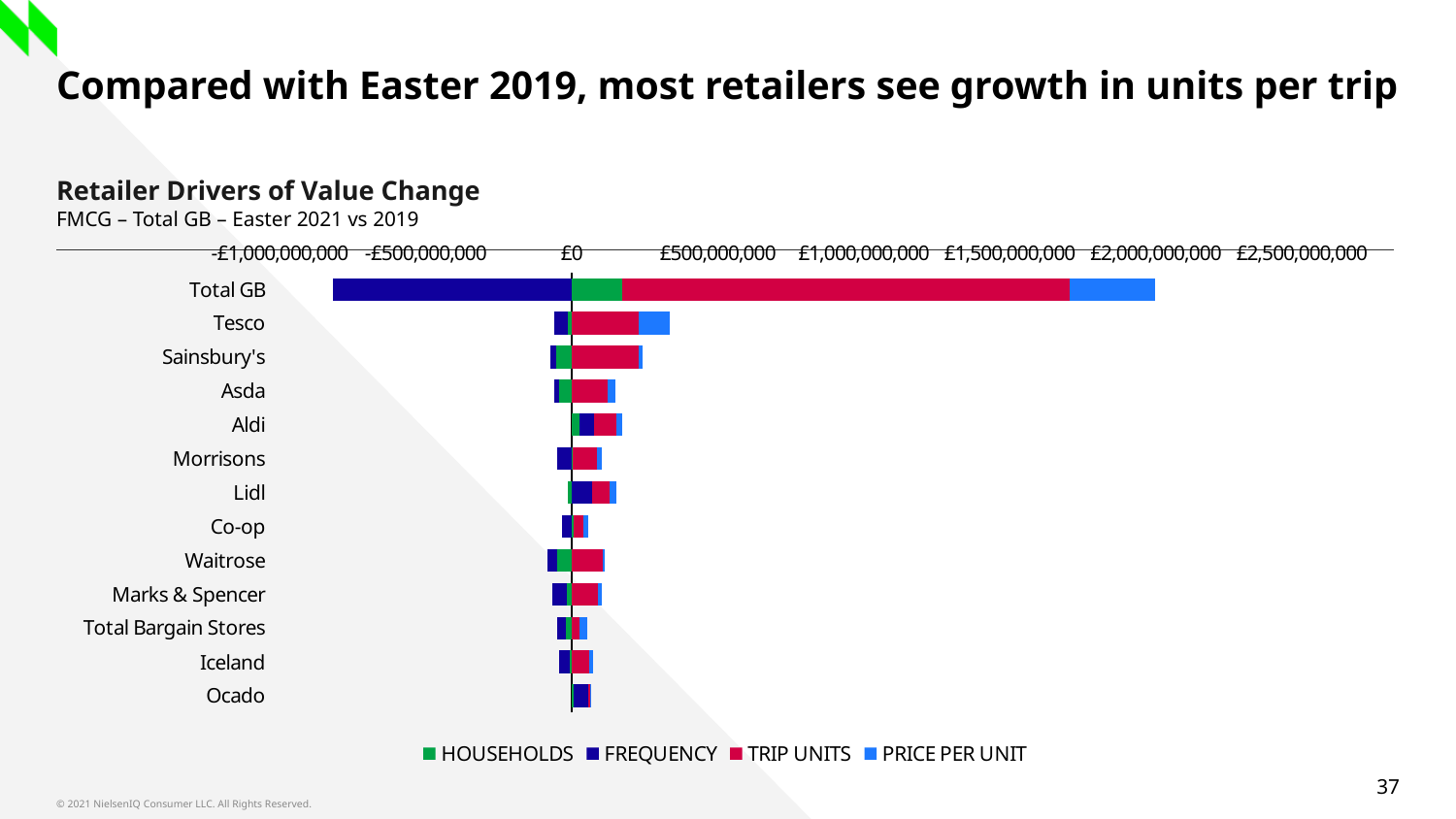
Is the TRIP UNITS value for Total GB greater or less than £1,000,000,000? greater How many retailer categories are plotted on the chart? 13 Is the PRICE PER UNIT value for Tesco greater or less than £500,000,000? less Is the FREQUENCY value for Total GB greater or less than -£500,000,000? less What kind of chart is shown on the slide? Stacked bar chart How many series does the legend list? 4 Which series makes the largest positive contribution for Total GB? TRIP UNITS What is the title of the chart? Retailer Drivers of Value Change Excluding Total GB, which retailer's bar extends furthest to the right? Tesco Which is larger, the TRIP UNITS value for Total GB or the TRIP UNITS value for Tesco? Total GB Which series is shown in green in the legend? HOUSEHOLDS Which series is negative for Total GB? FREQUENCY